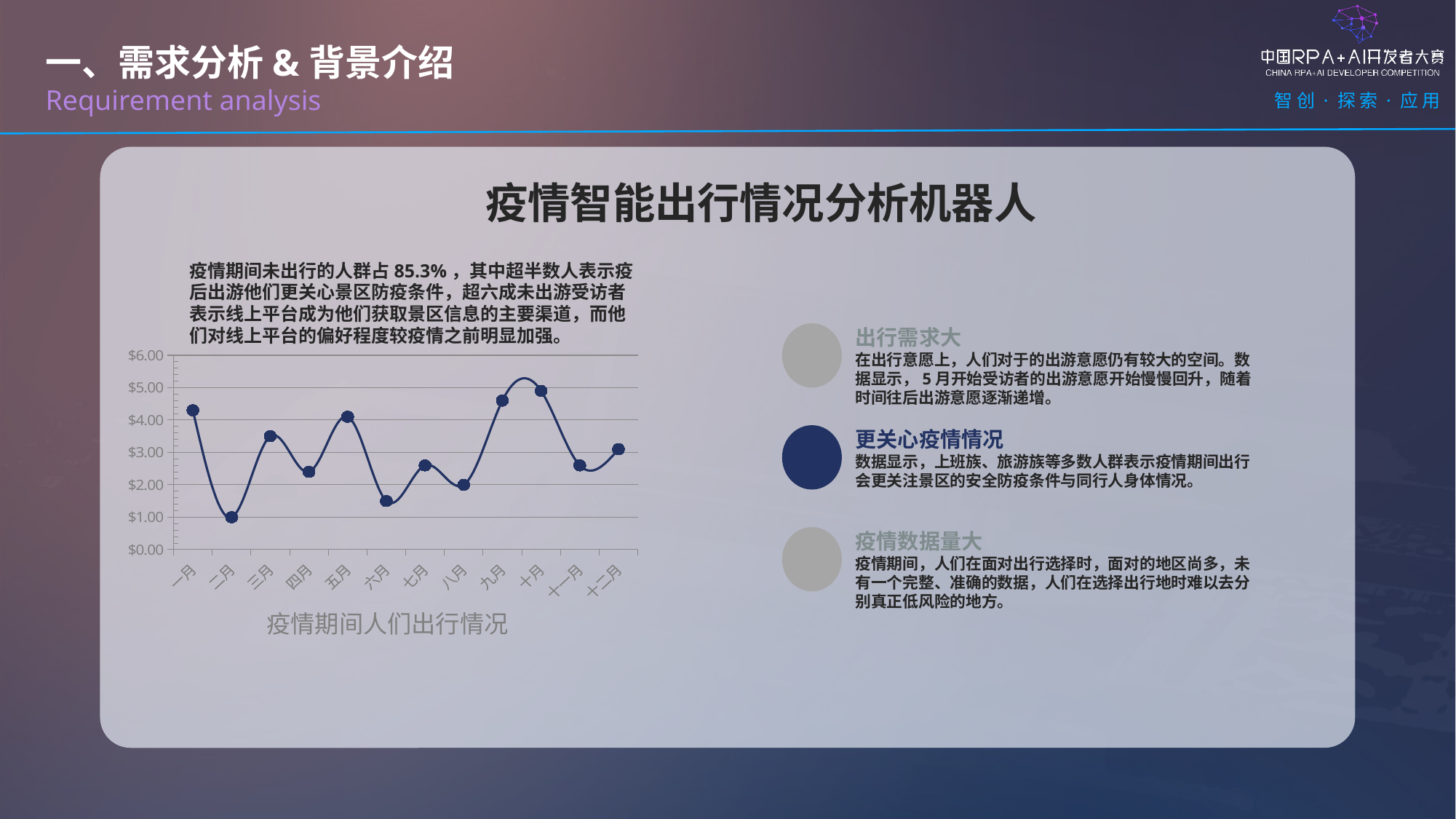
Does the value rise or fall from 一月 to 二月? fall What is the title of the chart? 疫情期间人们出行情况 What kind of chart is shown on the slide? line chart What is the value for 二月? $1.00 Is the value for 一月 greater or less than $4.00? greater What is the value for 八月? $2.00 Is the value for 六月 greater or less than $2.00? less How many months are plotted on the x axis of the chart? 12 Which month has the lowest value in the chart? 二月 Is the value for 四月 greater or less than $3.00? less Which month has the highest value in the chart? 十月 Which is larger, the value for 三月 or the value for 四月? 三月